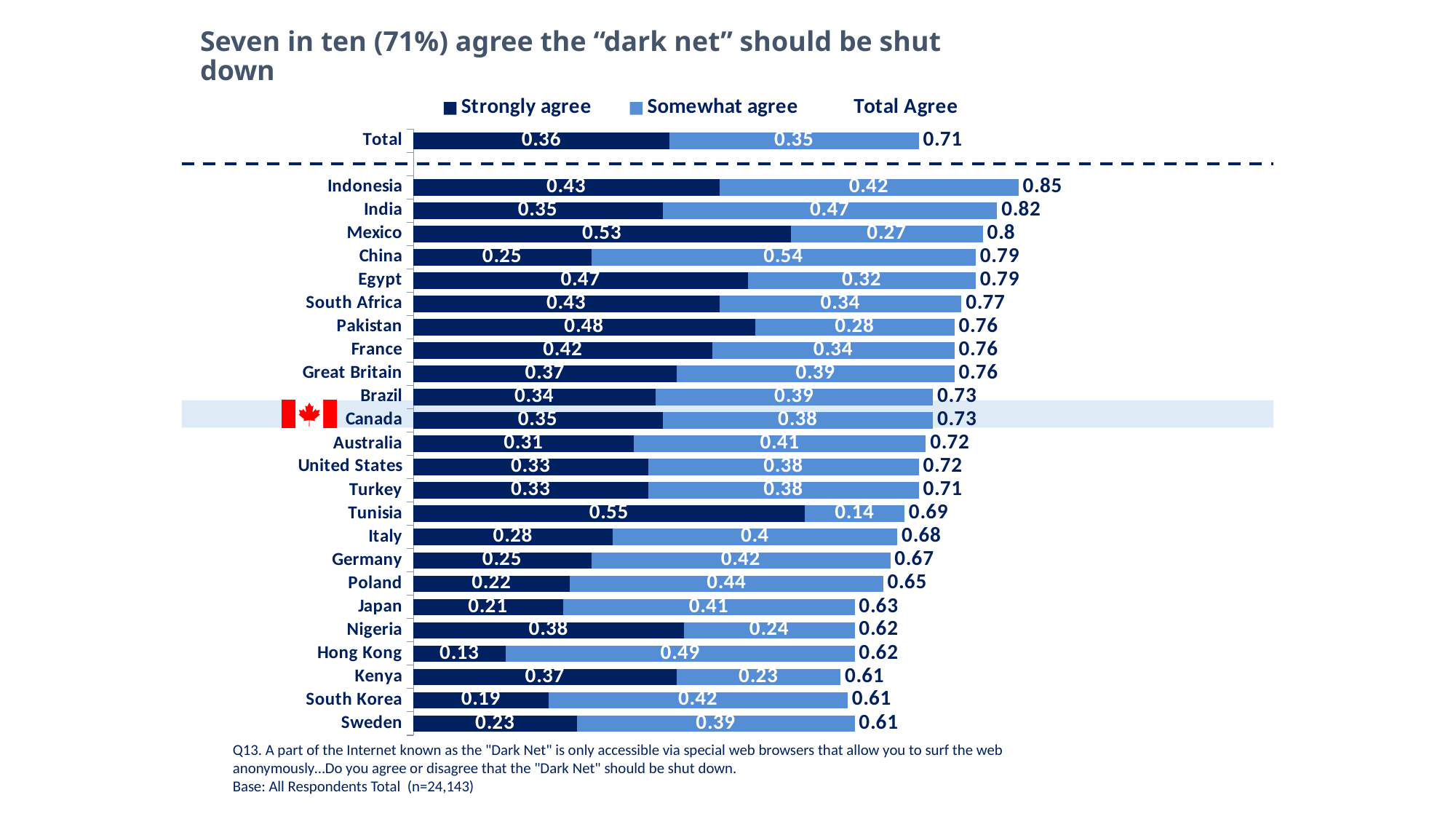
Which country has the highest Strongly agree value? Tunisia What kind of chart is shown on the slide? Stacked bar chart What is the difference between the Total Agree values for Indonesia and Sweden? 0.24 What is the Strongly agree value for Mexico? 0.53 How many countries (excluding the Total row) are shown in the chart? 24 What is the Total Agree value for the Total row? 0.71 Which country has the highest Total Agree value? Indonesia What is the Somewhat agree value for Hong Kong? 0.49 Which country has the lowest Strongly agree value? Hong Kong Which country's row is highlighted with a flag icon? Canada Which has a larger Strongly agree value, Mexico or Egypt? Mexico What is the Total Agree value for Indonesia? 0.85